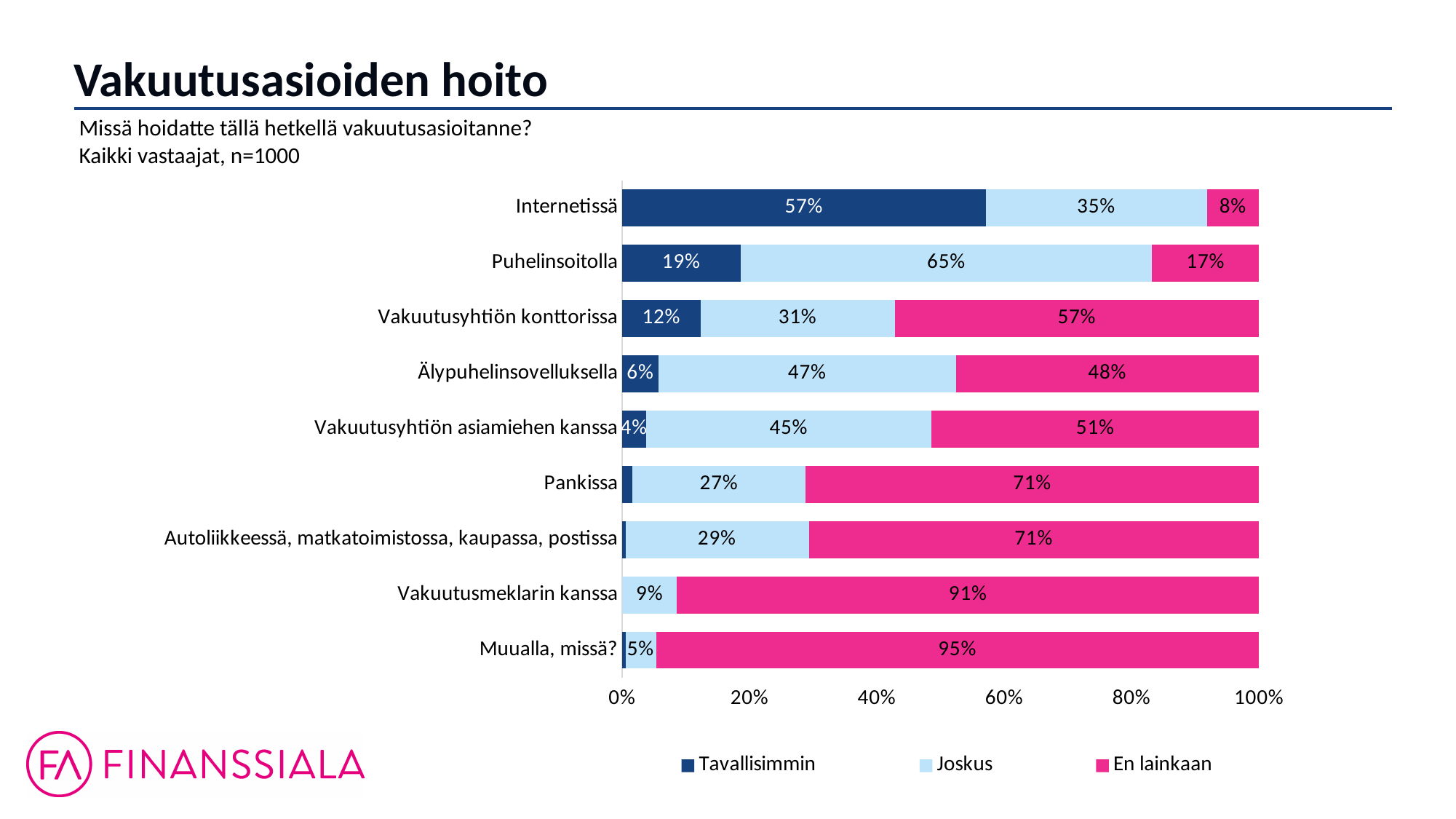
What kind of chart is shown on the slide? Stacked bar chart What percentage of respondents answered "Tavallisimmin" for Internetissä? 57% Is the "En lainkaan" value for Pankissa greater or less than 60%? greater What is the "Joskus" value for Puhelinsoitolla? 65% How many series does the legend list? 3 Which category has the highest "Tavallisimmin" share? Internetissä How many categories are shown on the chart? 9 Which category has the highest "En lainkaan" share? Muualla, missä? What is the difference in percentage points between the "En lainkaan" value for Vakuutusyhtiön konttorissa and for Internetissä? 49 percentage points Which category has the lowest "Joskus" share? Muualla, missä? Which has a larger "Joskus" value: Älypuhelinsovelluksella or Vakuutusyhtiön asiamiehen kanssa? Älypuhelinsovelluksella What is the "En lainkaan" value for Vakuutusmeklarin kanssa? 91%